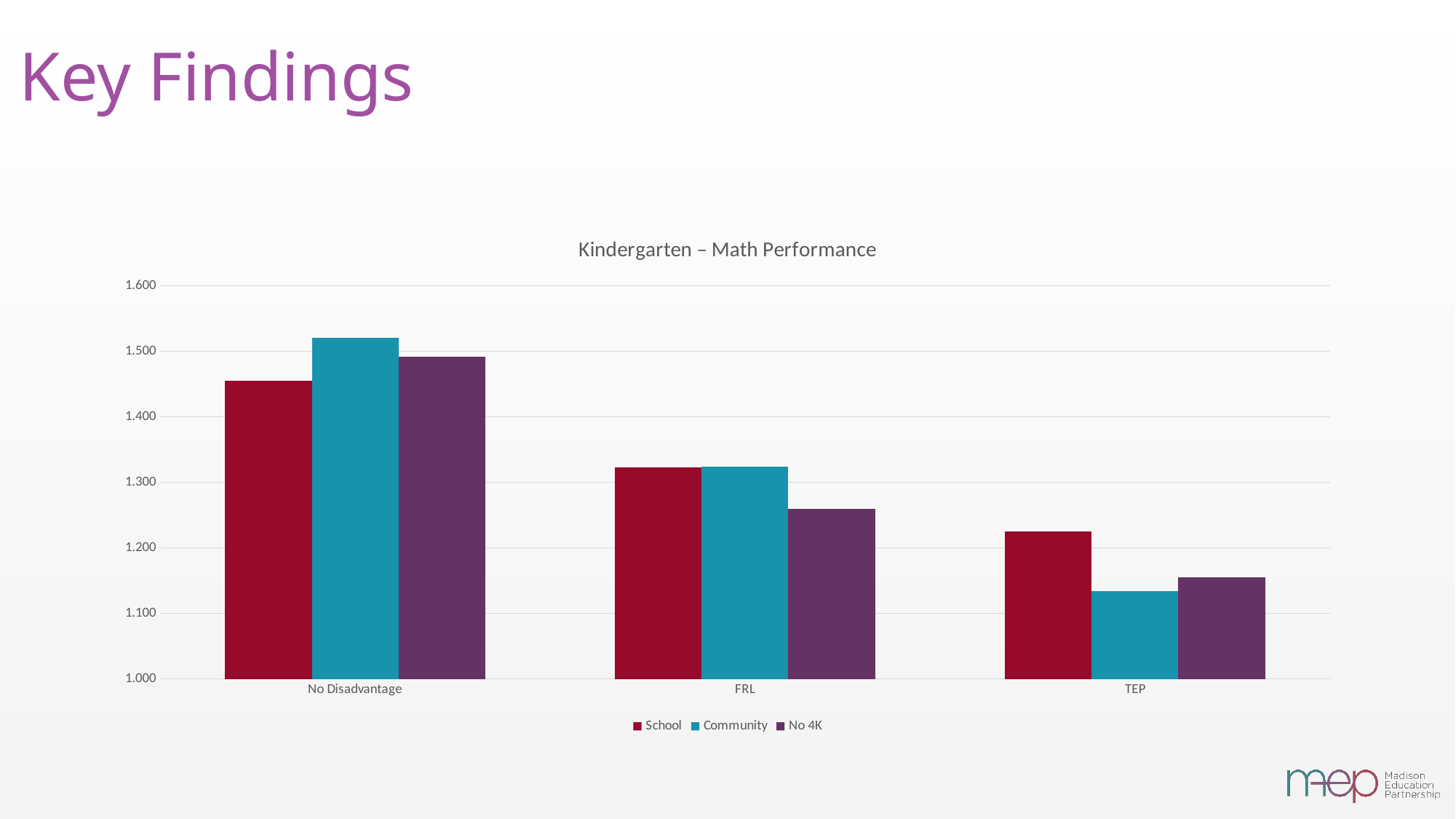
Which category has the highest Community value? No Disadvantage Which category has the lowest School value? TEP Is the Community value for TEP greater or less than 1.200? less Is the School value for No Disadvantage greater or less than 1.500? less How many categories are shown on the x axis? 3 What kind of chart is shown on the slide? bar chart How many series does the legend list? 3 Is the No 4K value for FRL greater or less than 1.300? less For TEP, which is larger, the School value or the Community value? School Which series is shown in teal in the legend? Community What is the title of the chart? Kindergarten – Math Performance